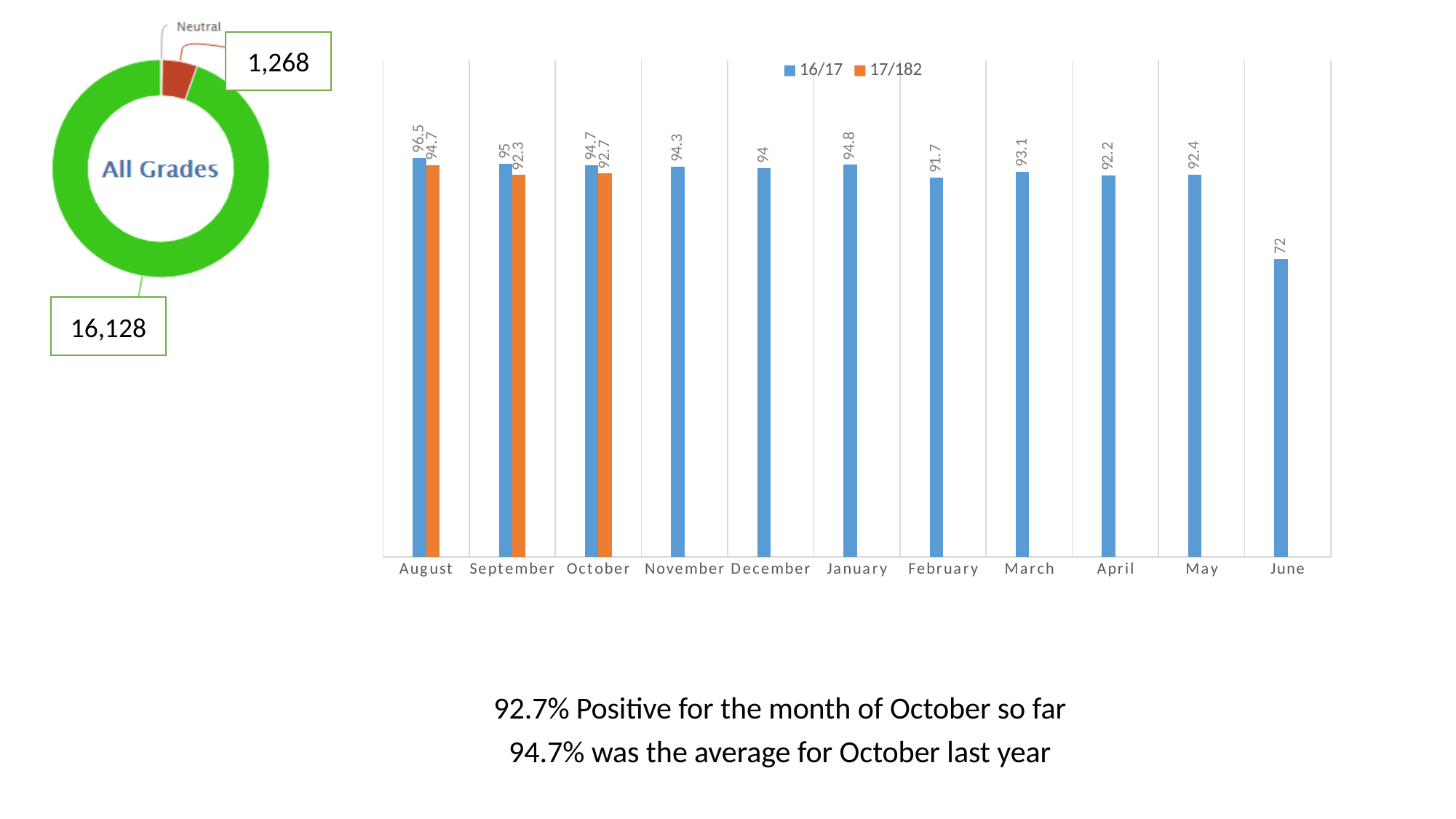
In the bar chart, which month has the lowest value for the 16/17 series? June In the bar chart, what is the value for the 17/182 series in October? 92.7 In the bar chart, what is the value for the 16/17 series in June? 72 How many months are shown on the x axis of the bar chart? 11 What kind of chart is the chart on the right of the slide? Bar chart How many series does the legend of the bar chart list? 2 In the bar chart, what is the difference between the 16/17 and 17/182 values in August? 1.8 In the bar chart, which series has the larger value in September, 16/17 or 17/182? 16/17 In the bar chart, what is the difference between the 16/17 and 17/182 values in October? 2 In the bar chart, which month has the highest value for the 16/17 series? August In the bar chart, what is the value for the 16/17 series in August? 96.5 In the All Grades chart on the left, what is the value of the Neutral slice? 1,268